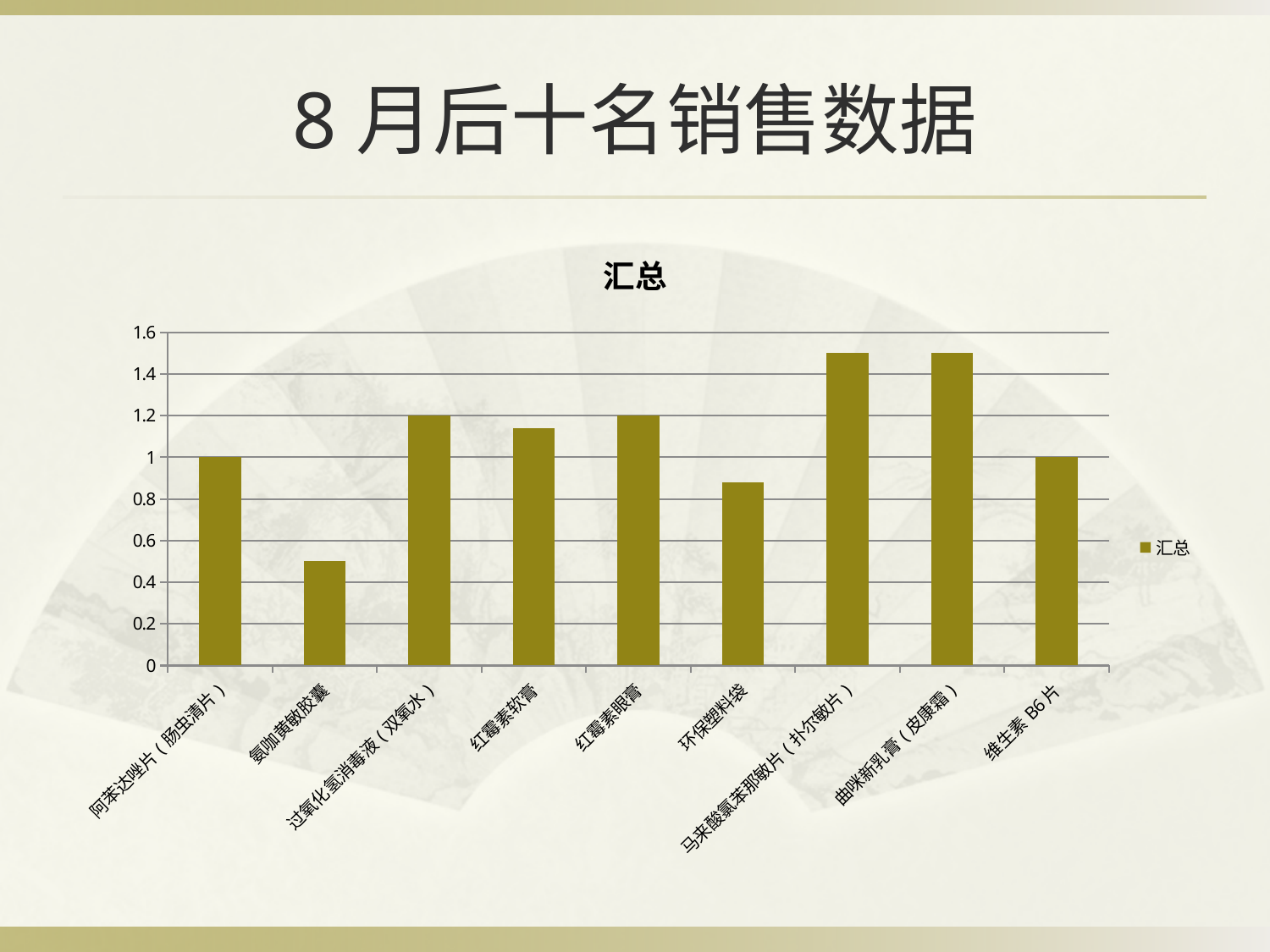
Is the value for 环保塑料袋 greater or less than 1? less What is the title of the chart? 汇总 How many categories are plotted on the x axis? 9 What is the value for 阿苯达唑片（肠虫清片）? 1 What is the value for 维生素B6片? 1 Is the value for 氨咖黄敏胶囊 greater or less than 0.6? less Is the value for 马来酸氯苯那敏片（扑尔敏片） greater or less than 1.4? greater Which is larger, the value for 红霉素软膏 or the value for 氨咖黄敏胶囊? 红霉素软膏 What is the value for 过氧化氢消毒液（双氧水）? 1.2 What kind of chart is shown on the slide? Bar chart How many series does the legend list? 1 Which category has the lowest value? 氨咖黄敏胶囊